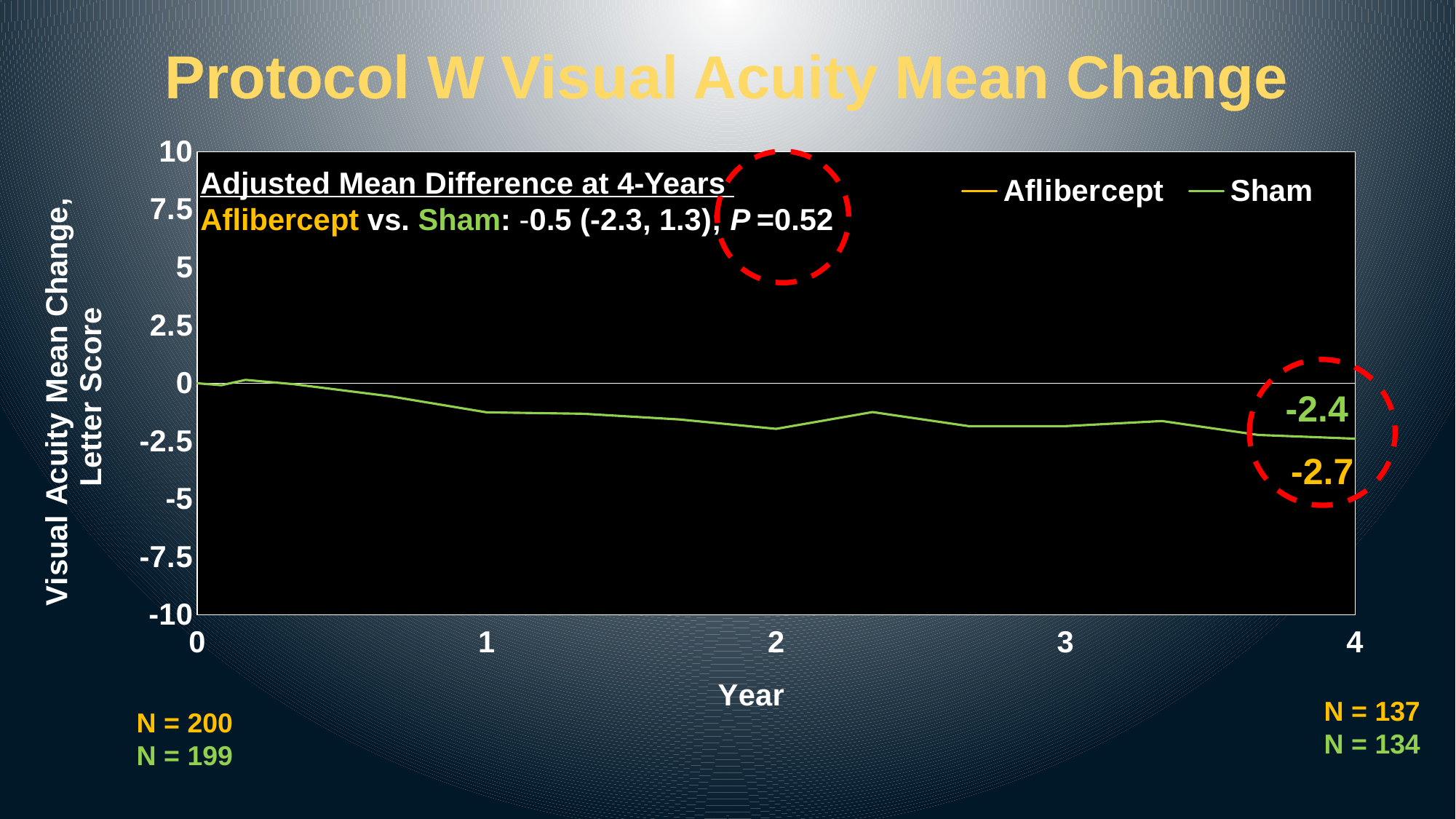
How many series does the legend list? 2 What is the visual acuity mean change for Sham at year 4? -2.4 Is the Sham value at year 1 greater or less than -2.5? greater Does the Sham line rise or fall from year 0 to year 4? fall What is the visual acuity mean change for Aflibercept at year 4? -2.7 What is the title of the chart? Protocol W Visual Acuity Mean Change What is the difference between the Sham and Aflibercept values at year 4? 0.3 What is the label of the x axis? Year What kind of chart is shown on the slide? line chart At year 4, which group has the higher visual acuity mean change, Aflibercept or Sham? Sham Is the Sham value at year 2 greater or less than 0? less